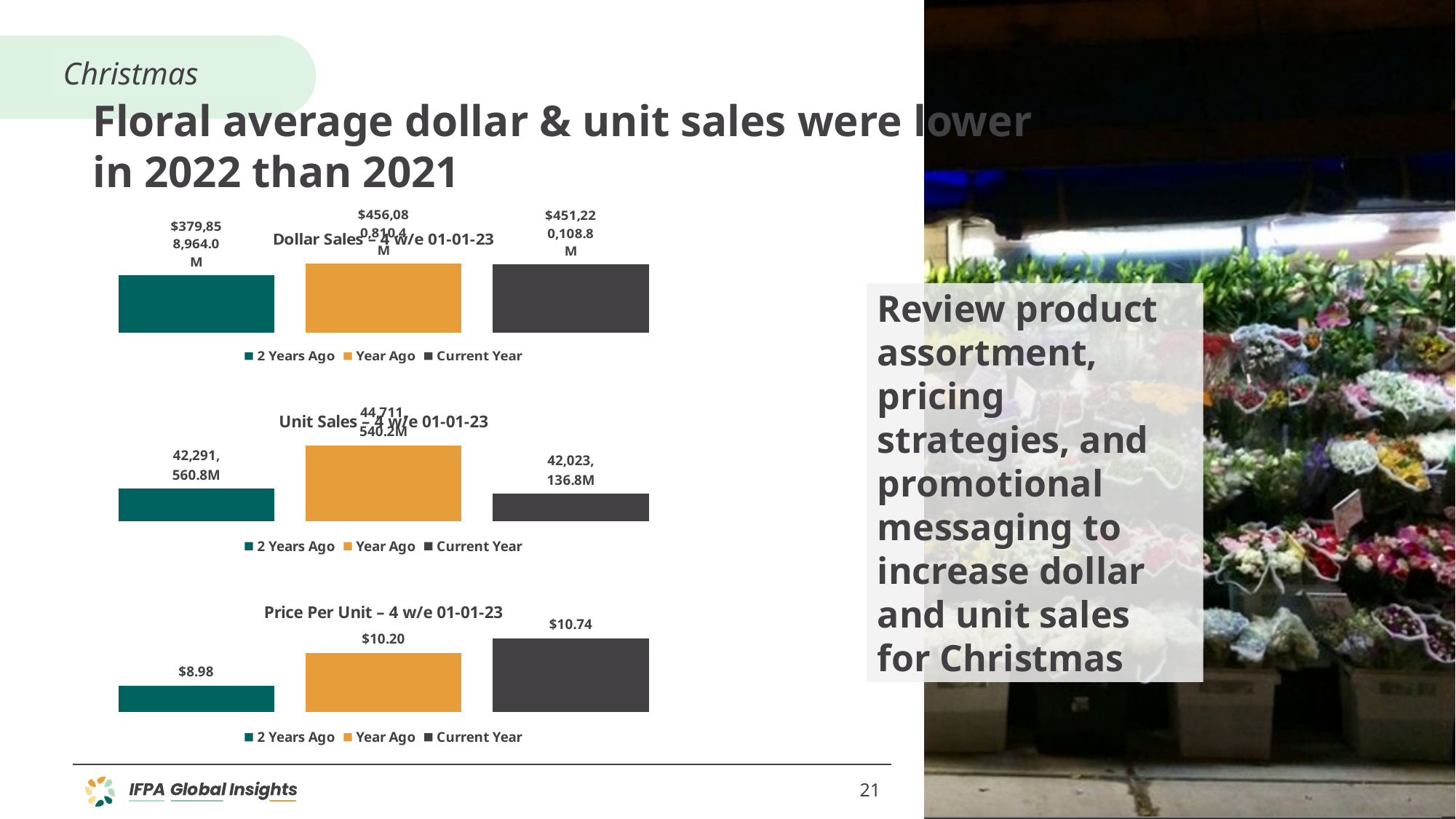
In the Price Per Unit chart, which period has the highest price per unit? Current Year In the Price Per Unit chart, what is the value for 2 Years Ago? $8.98 In the Price Per Unit chart, what is the value for Current Year? $10.74 In the Unit Sales chart, what is the value for Current Year? 42,023,136.8M In the Price Per Unit chart, what is the value for Year Ago? $10.20 How many series does the legend of the Unit Sales chart list? 3 In the Price Per Unit chart, what is the difference between the Current Year and Year Ago values? $0.54 In the Unit Sales chart, which period has the highest unit sales? Year Ago In the Price Per Unit chart, what is the difference between the Current Year and 2 Years Ago values? $1.76 In the Dollar Sales chart, which period has the lowest dollar sales? 2 Years Ago In the Dollar Sales chart, which is larger: Year Ago or Current Year? Year Ago In the Price Per Unit chart, which period has the lowest price per unit? 2 Years Ago